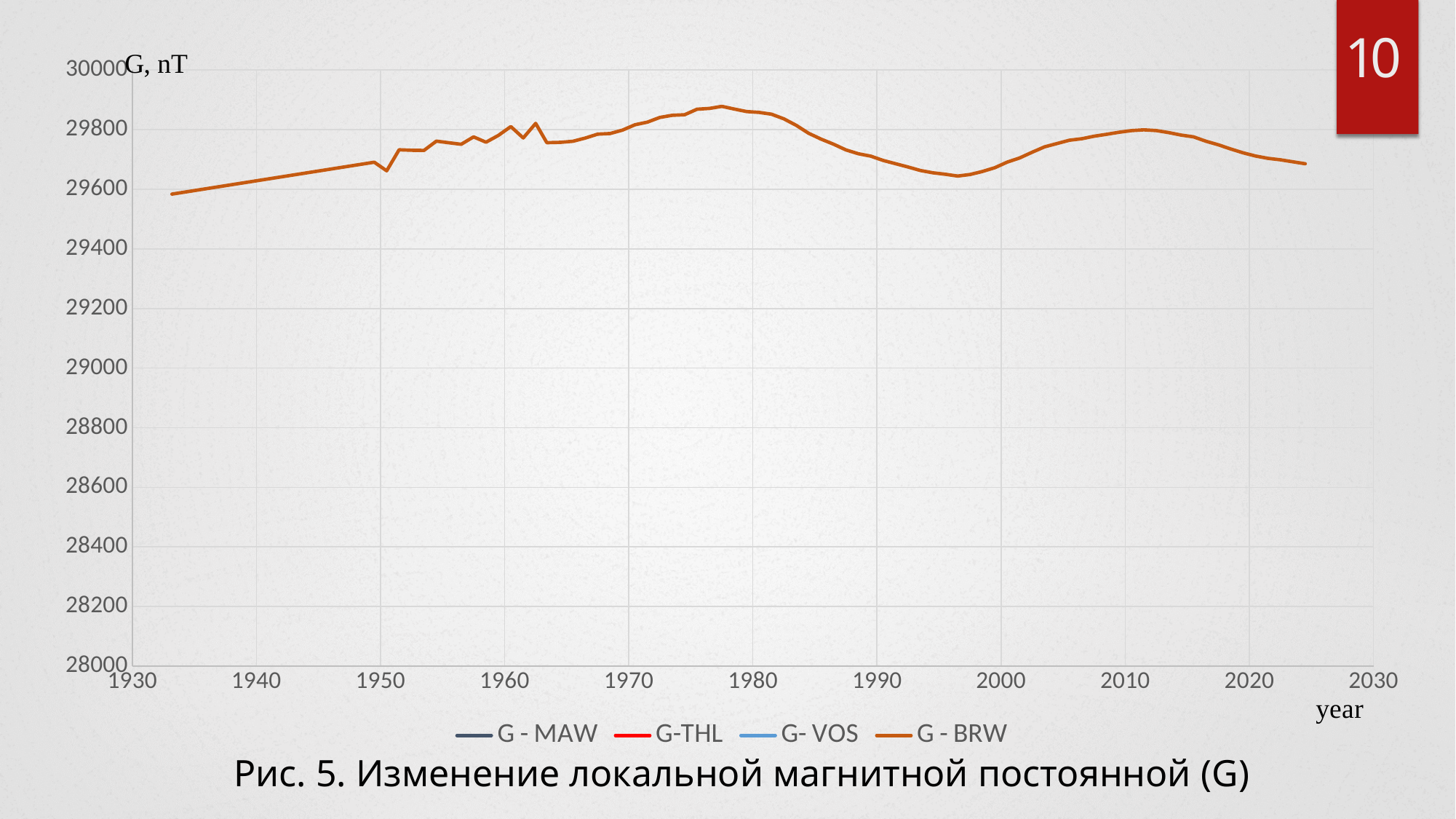
Is the value of the G - BRW line around 1997 greater or less than 29800? less Is the value of the G - BRW line around 1977 greater or less than 29800? greater Does the G - BRW line rise or fall between 1980 and 1997? fall How many series does the legend list? 4 Is the value of the G - BRW line around 2024 greater or less than 29800? less Which series is plotted as the orange line? G - BRW What kind of chart is shown on the slide? line chart What is the label of the vertical axis? G, nT Does the G - BRW line rise or fall between 1933 and 1977? rise Does the G - BRW line rise or fall between 2012 and 2024? fall